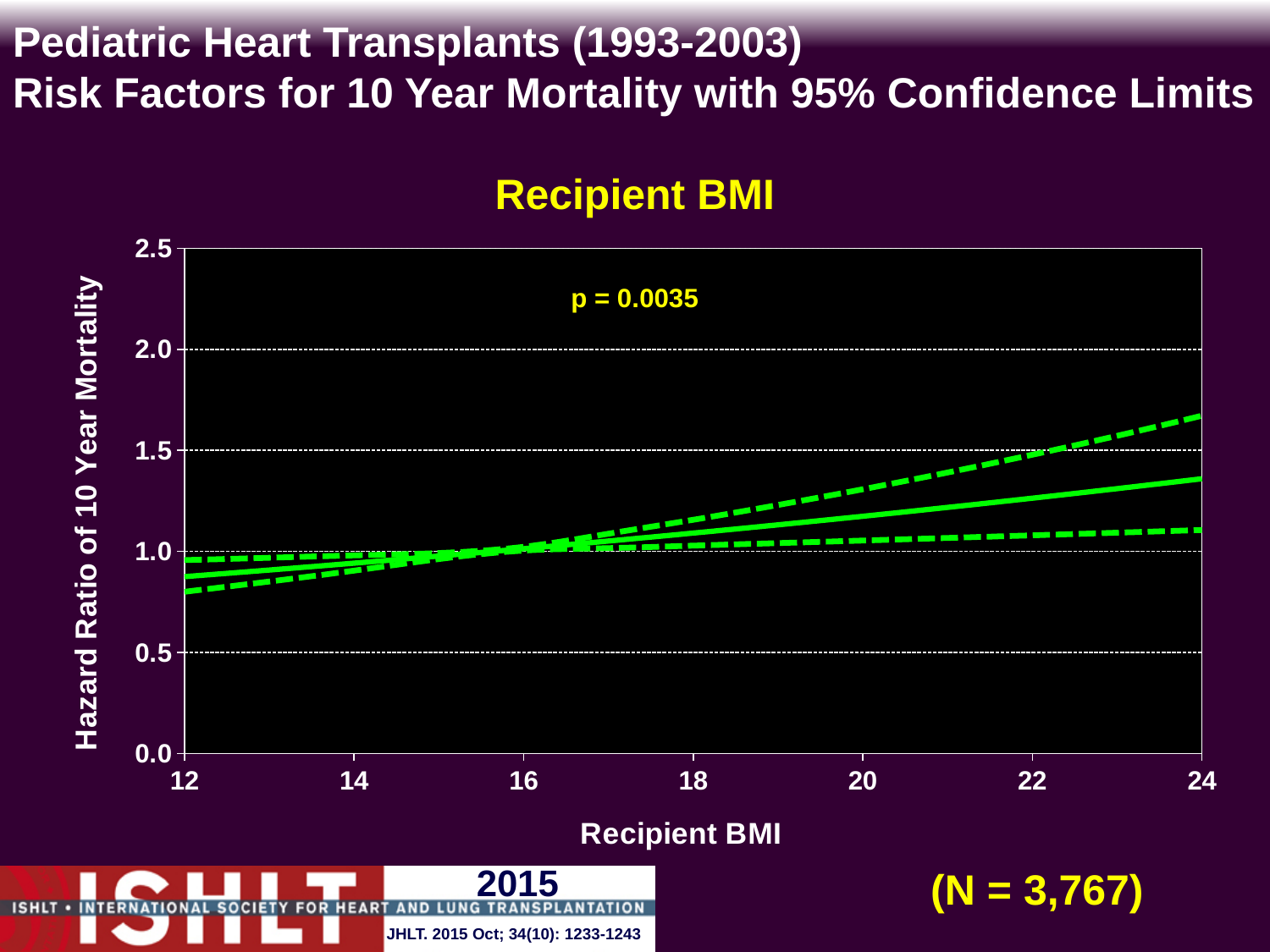
Is the lower 95% confidence limit (lower dashed line) at a recipient BMI of 24 greater or less than 1.0? greater What p-value is printed on the chart? p = 0.0035 Does the hazard ratio of 10 year mortality rise or fall as recipient BMI increases from 12 to 24? rise What kind of chart is shown on the slide? line chart Is the hazard ratio (solid line) at a recipient BMI of 12 greater or less than 1.0? less What is the highest value shown on the y axis of the chart? 2.5 Is the upper 95% confidence limit (upper dashed line) at a recipient BMI of 24 greater or less than 1.5? greater How many lines are plotted on the chart? 3